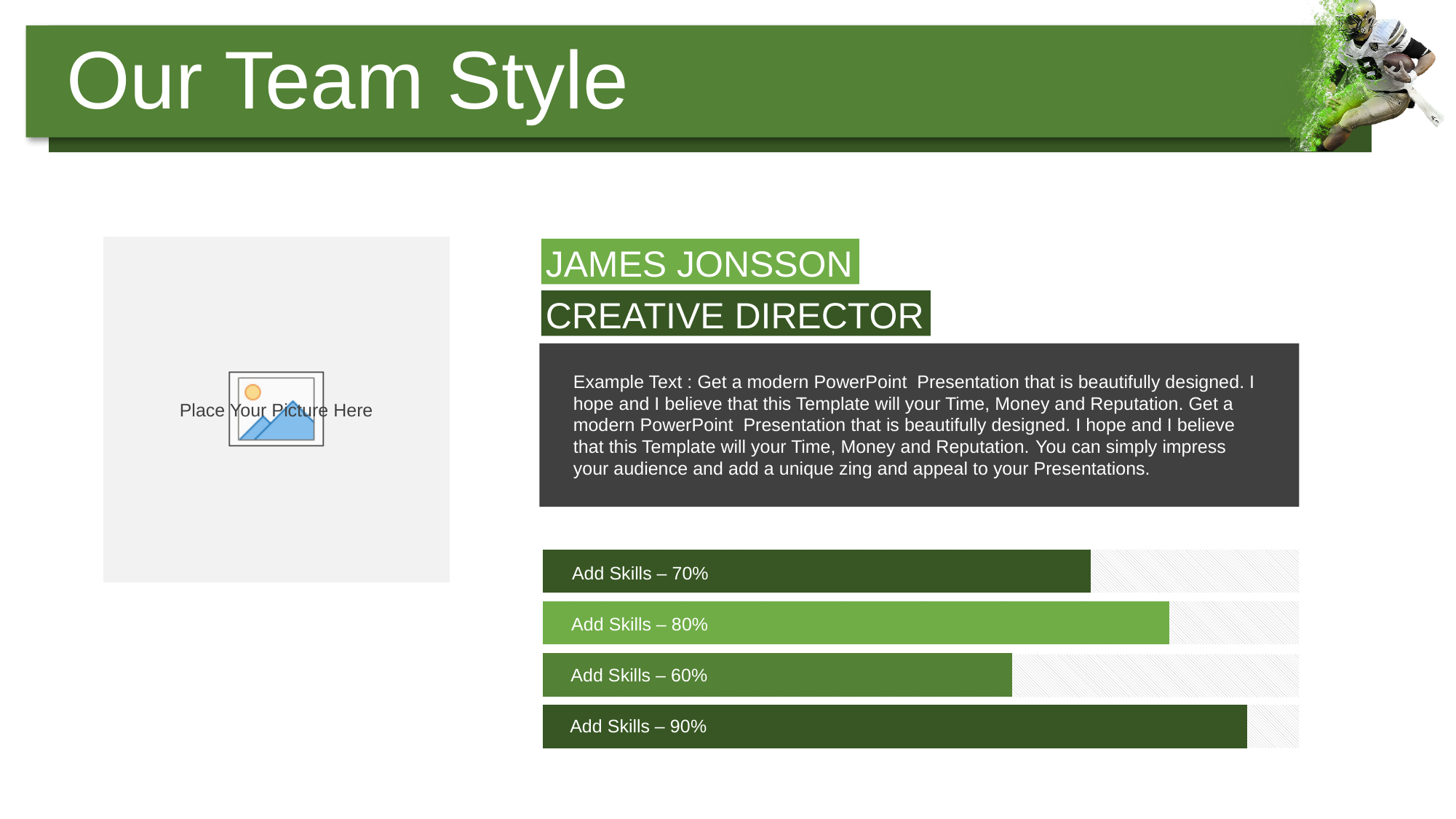
What kind of chart is used to show the skills? Bar chart Which skill bar has the highest value? The fourth (bottom) bar, 90% How many skill bars are shown on the slide? 4 What is the difference between the second bar (80%) and the first bar (70%)? 10% What value is shown on the third skill bar from the top? 60% What value is shown on the first (top) skill bar? 70% What value is shown on the fourth (bottom) skill bar? 90% What value is shown on the second skill bar from the top? 80% Which skill bar has the lowest value? The third bar, 60% Which is larger, the value of the first bar or the value of the third bar? The first bar (70%) What text label appears on each of the skill bars? Add Skills What is the difference between the highest and lowest skill bar values? 30%